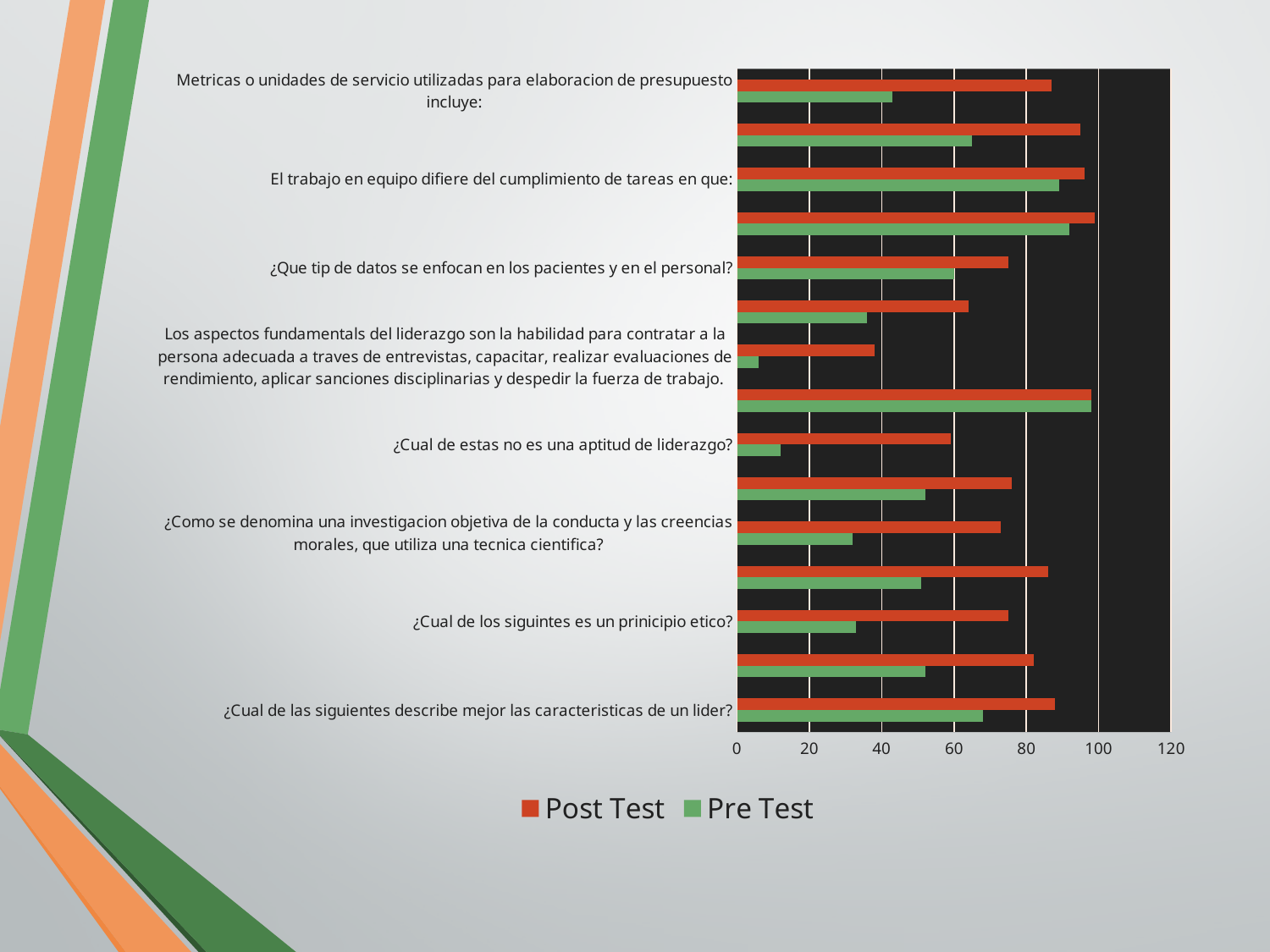
Which series is shown in red in the legend? Post Test Which is larger: the Pre Test value for "Metricas o unidades de servicio..." or the Pre Test value for "¿Cual de estas no es una aptitud de liderazgo?"? Metricas o unidades de servicio... Is the Pre Test value for "¿Cual de estas no es una aptitud de liderazgo?" greater or less than 20? less Is the Post Test value for "Metricas o unidades de servicio utilizadas para elaboracion de presupuesto incluye:" greater or less than 80? greater Which series is shown in green in the legend? Pre Test Is the Pre Test value for "El trabajo en equipo difiere del cumplimiento de tareas en que:" greater or less than 80? greater Among the labeled categories, which has the lowest Pre Test value? Los aspectos fundamentals del liderazgo... For "Metricas o unidades de servicio utilizadas para elaboracion de presupuesto incluye:", which is larger, the Post Test or the Pre Test value? Post Test What kind of chart is shown on the slide? bar chart How many series does the legend list? 2